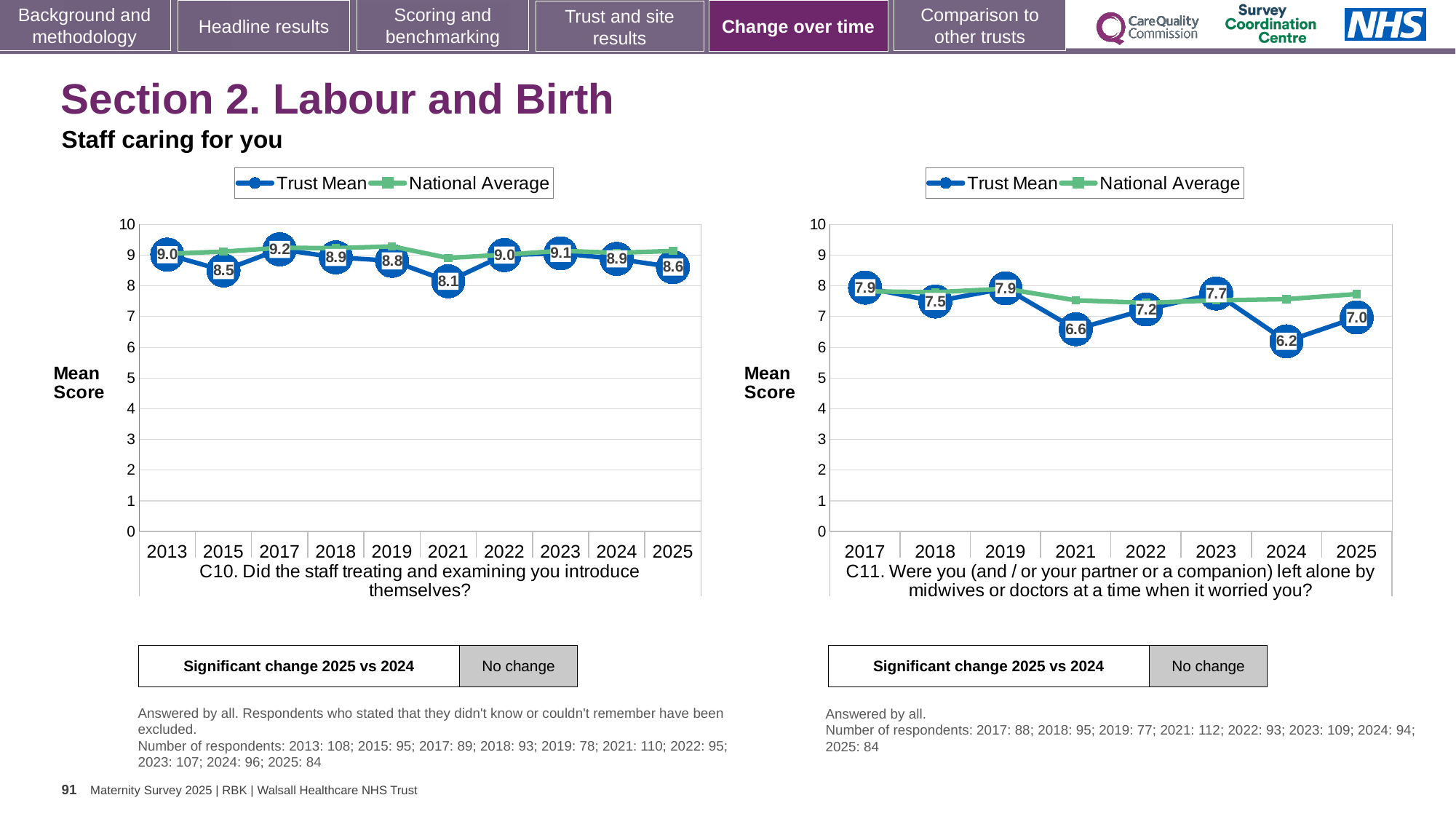
In the C10 chart (left), what is the difference between the Trust Mean scores for 2017 and 2021? 1.1 In the C11 chart (right), which is larger: the Trust Mean score for 2018 or for 2022? 2018 What kind of chart is the C10 chart (left)? Line chart In the C11 chart (right), what is the Trust Mean score for 2024? 6.2 In the C10 chart (left), which year has the highest Trust Mean score? 2017 In the C11 chart (right), what does the box labelled 'Significant change 2025 vs 2024' say? No change How many years are plotted on the x axis of the C10 chart (left)? 10 In the C11 chart (right), what is the difference between the Trust Mean scores for 2025 and 2024? 0.8 In the C10 chart (left), what is the Trust Mean score for 2021? 8.1 How many series does the legend of the C11 chart (right) list? 2 In the C11 chart (right), is the National Average for 2025 greater or less than 7? greater In the C11 chart (right), which year has the lowest Trust Mean score? 2024